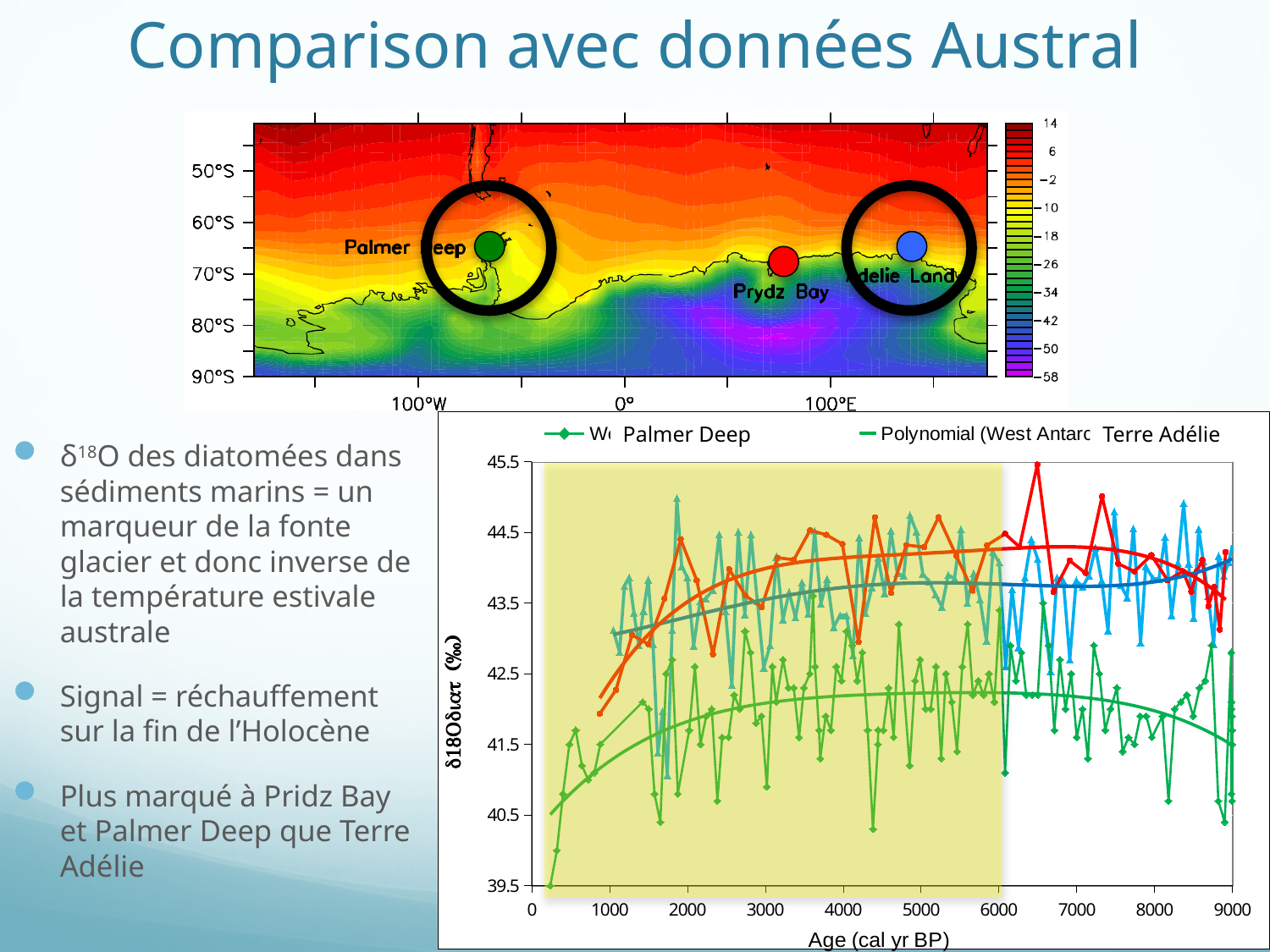
On the map at the top of the slide, what is the highest value on the colour scale? 14 In the bottom-right line chart, what is the title of the x axis? Age (cal yr BP) In the bottom-right line chart, how many tick labels are shown on the y axis? 7 In the bottom-right line chart, is the first point of the green Palmer Deep series near age 200 greater or less than 40.5? less In the bottom-right line chart, what is the highest value shown on the x axis? 9000 In the bottom-right line chart, how many tick labels are shown on the x axis? 10 What kind of chart is shown at the bottom right of the slide? line chart On the map at the top of the slide, how many sampling sites are labelled? 3 In the bottom-right line chart, are the values of the green Palmer Deep series greater or less than 44.5 across the whole record? less In the bottom-right line chart, is the peak of the red series near age 6500 greater or less than 44.5? greater In the bottom-right line chart, does the green Palmer Deep series rise or fall between age 200 and age 1000? rise In the bottom-right line chart, which series has higher values overall, the red series or the green Palmer Deep series? the red series